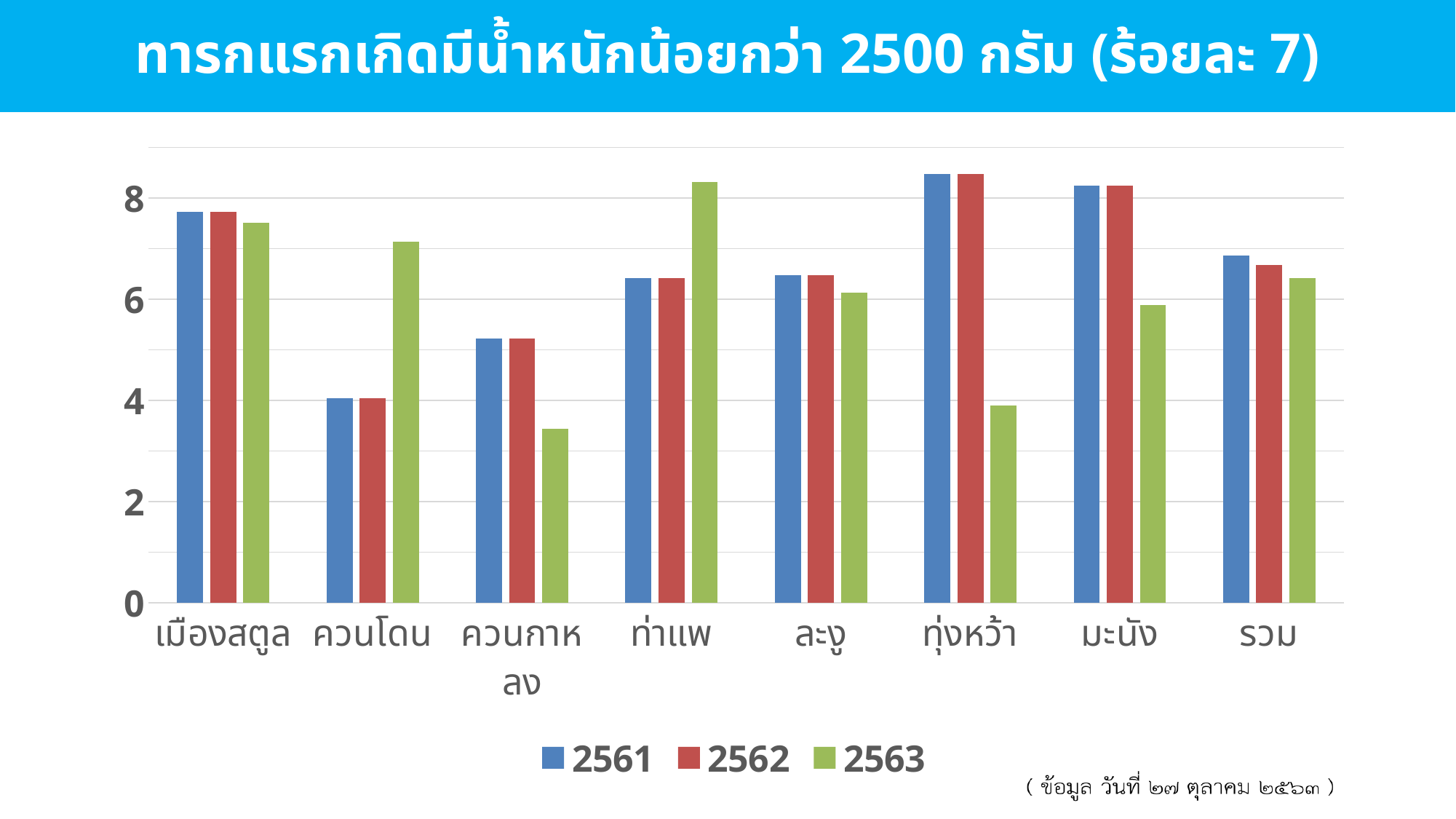
Is the 2563 value for ควนกาหลง greater or less than 4? less Is the 2561 value for ทุ่งหว้า greater or less than 8? greater How many series does the legend list? 3 Is the 2563 value for ควนโดน greater or less than 6? greater For ทุ่งหว้า, which series has the larger value, 2561 or 2563? 2561 Which category has the lowest value for the 2561 series? ควนโดน Which category has the highest value for the 2563 series? ท่าแพ For รวม, do the values rise or fall from 2561 to 2563? fall Which colour represents the 2563 series in the legend? green How many categories are shown along the x axis? 8 What kind of chart is shown on the slide? bar chart